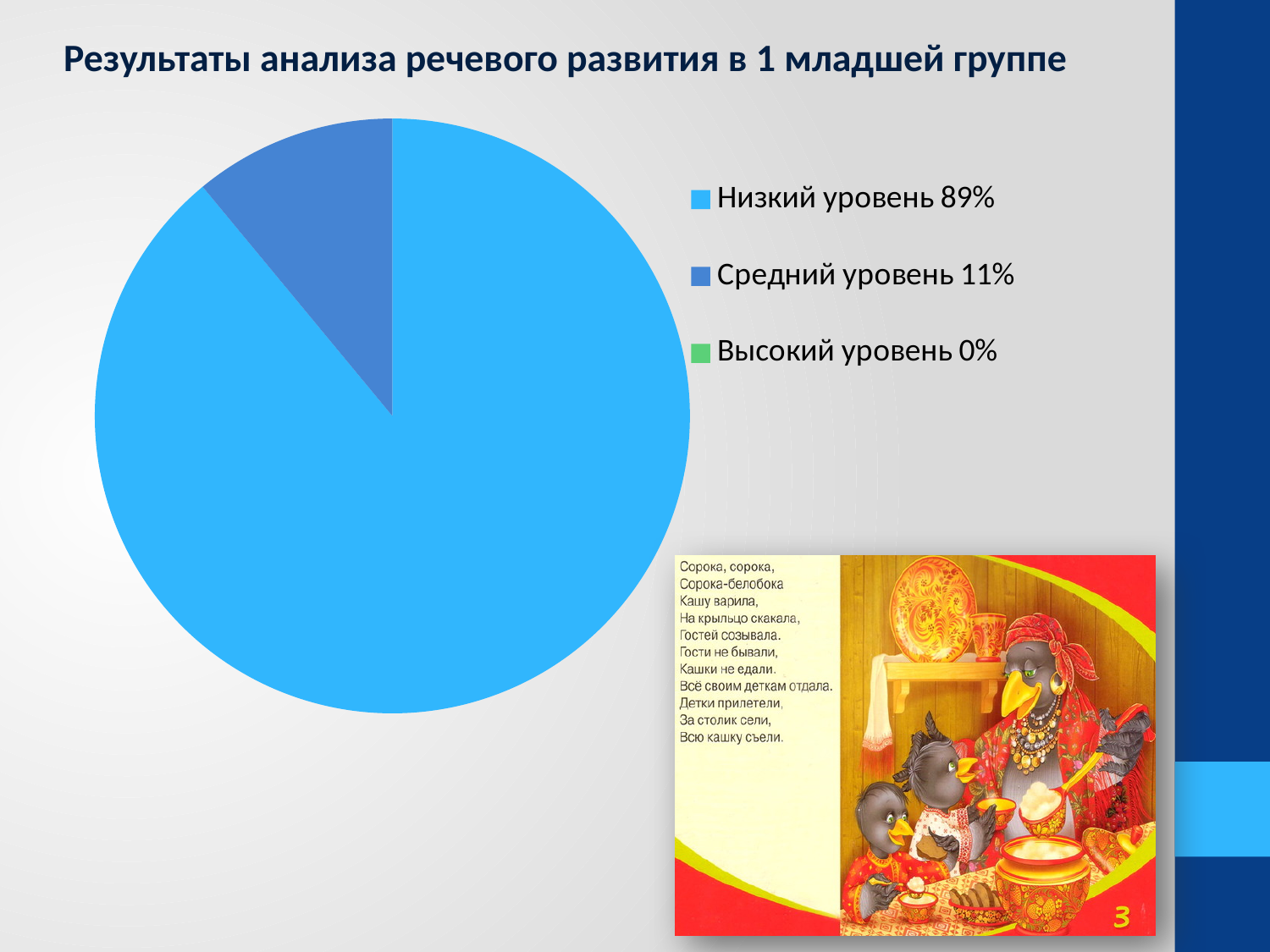
How many categories does the legend list? 3 What is the title of the slide with the pie chart? Результаты анализа речевого развития в 1 младшей группе What share of the pie does "Низкий уровень" have? 89% What share of the pie does "Средний уровень" have? 11% Which is larger, the share of "Средний уровень" or the share of "Высокий уровень"? Средний уровень What share of the pie does "Высокий уровень" have? 0% Which category has the smallest share of the pie? Высокий уровень What colour is used for "Высокий уровень" in the legend? green What kind of chart is shown on the slide? pie chart What is the difference between the shares of "Низкий уровень" and "Средний уровень"? 78% Which category has the largest share of the pie? Низкий уровень